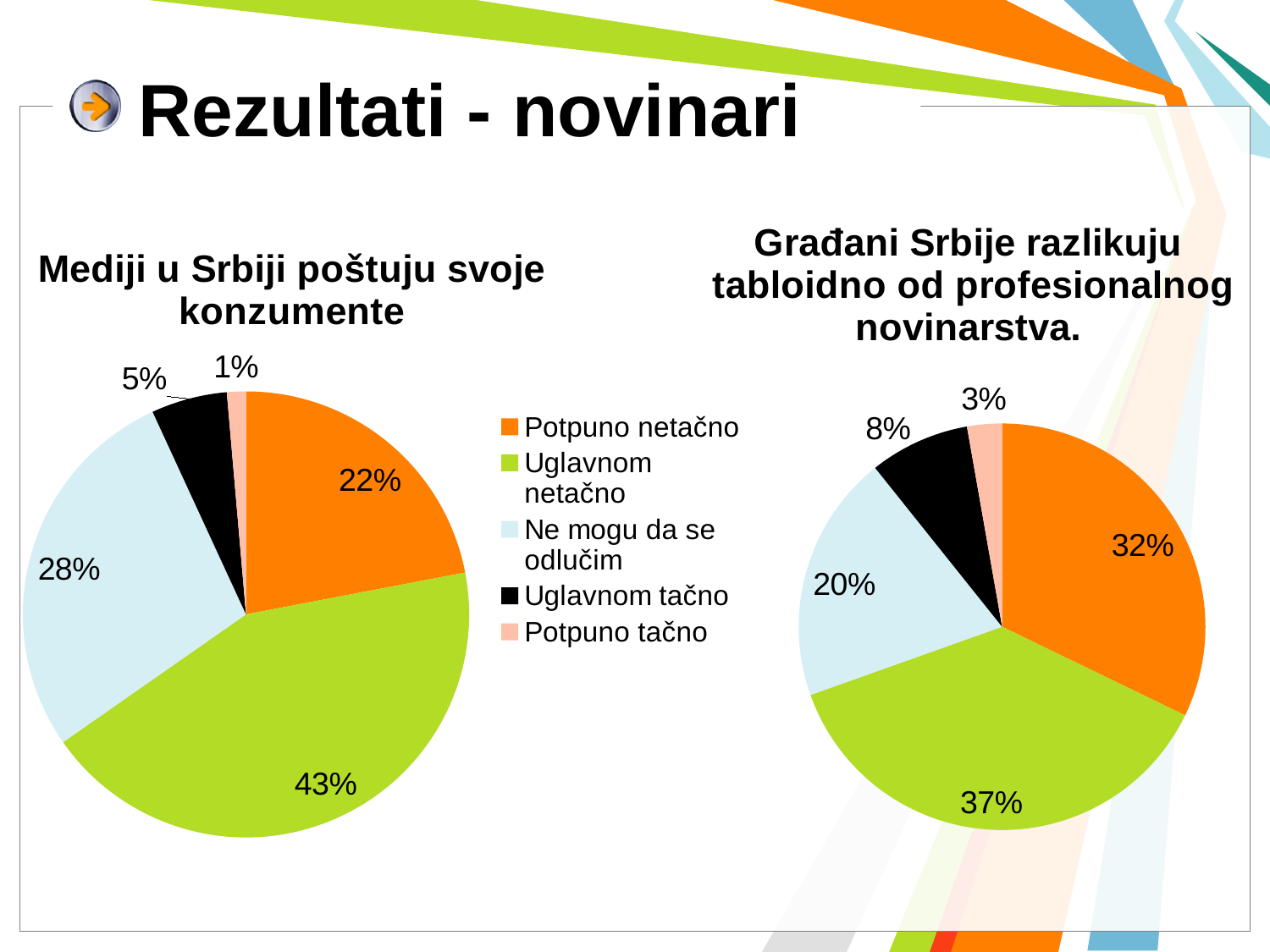
In the pie chart titled "Građani Srbije razlikuju tabloidno od profesionalnog novinarstva.", what share is labelled for Ne mogu da se odlučim? 20% In the pie chart titled "Građani Srbije razlikuju tabloidno od profesionalnog novinarstva.", what is the difference between the Uglavnom netačno and Uglavnom tačno shares? 29% In the pie chart titled "Mediji u Srbiji poštuju svoje konzumente", which category has the largest slice? Uglavnom netačno In the pie chart titled "Građani Srbije razlikuju tabloidno od profesionalnog novinarstva.", which category has the smallest slice? Potpuno tačno In the pie chart titled "Mediji u Srbiji poštuju svoje konzumente", what is the difference between the Uglavnom netačno and Potpuno netačno shares? 21% In the pie chart titled "Građani Srbije razlikuju tabloidno od profesionalnog novinarstva.", what share is labelled for Potpuno netačno? 32% In the pie chart titled "Mediji u Srbiji poštuju svoje konzumente", which is larger: Ne mogu da se odlučim or Potpuno netačno? Ne mogu da se odlučim In the pie chart titled "Mediji u Srbiji poštuju svoje konzumente", what share is labelled for Uglavnom netačno? 43% How many categories does the legend list for the pie charts? 5 In the pie chart titled "Mediji u Srbiji poštuju svoje konzumente", what share is labelled for Potpuno tačno? 1% What colour is the Uglavnom tačno slice in the pie charts? Black What kind of chart is used on the left side of the slide? Pie chart